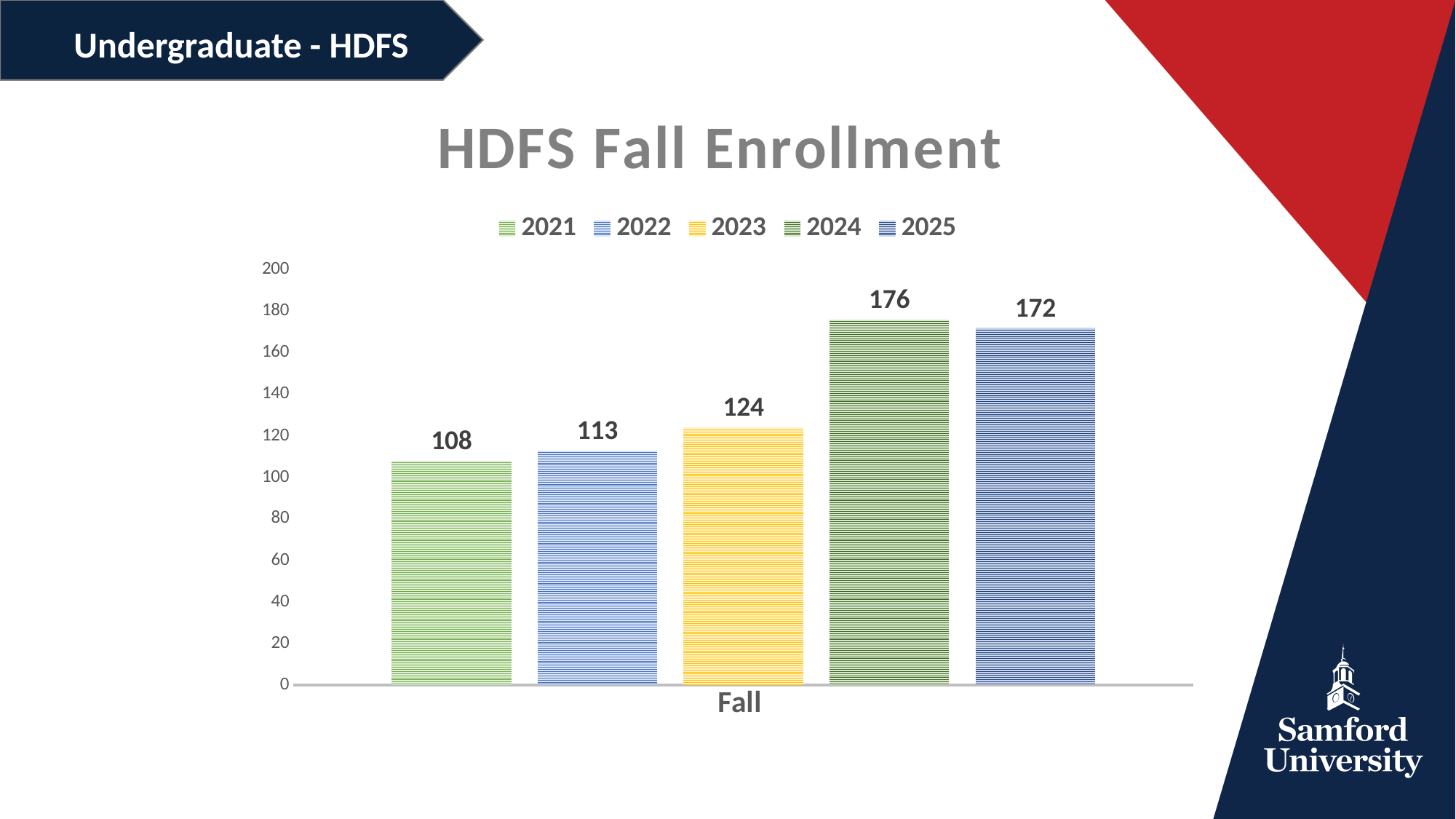
What is the HDFS fall enrollment for 2025? 172 What is the difference in fall enrollment between 2024 and 2021? 68 What kind of chart is shown on the slide? bar chart What is the difference in fall enrollment between 2023 and 2022? 11 How many series does the legend list? 5 What is the title of the chart? HDFS Fall Enrollment Which year has the lowest HDFS fall enrollment? 2021 Which year has the highest HDFS fall enrollment? 2024 What is the HDFS fall enrollment for 2024? 176 Is the fall enrollment for 2023 greater or less than 140? less Which year has the larger fall enrollment, 2022 or 2025? 2025 What is the HDFS fall enrollment for 2021? 108